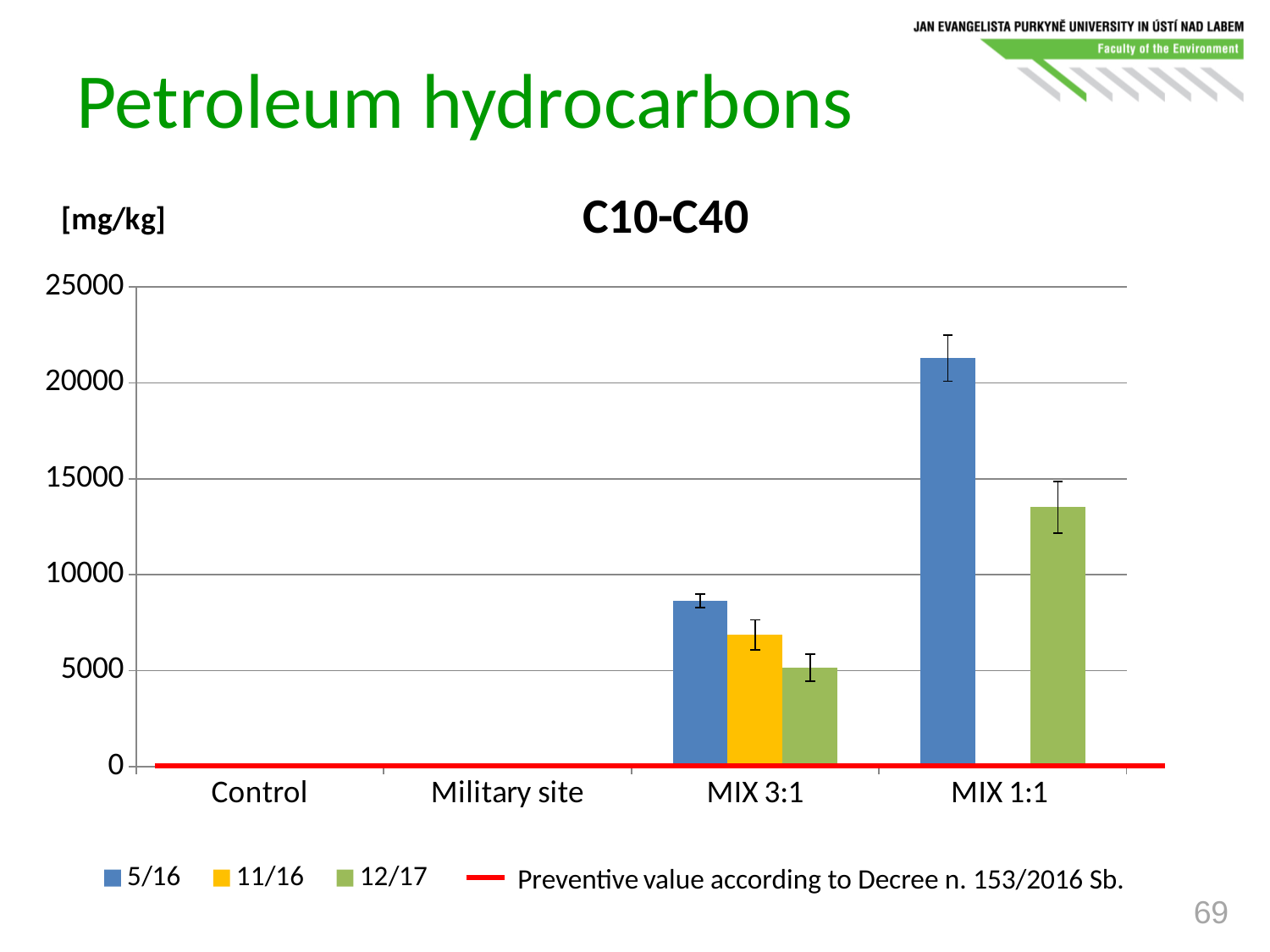
What kind of chart is shown on the slide? bar chart What unit is shown for the y axis of the chart? [mg/kg] How many categories are shown on the x axis of the chart? 4 How many entries does the chart legend list? 4 Is the 5/16 value for MIX 3:1 greater or less than 10000? less Which is larger for MIX 3:1, the 5/16 value or the 12/17 value? 5/16 Is the 5/16 value for MIX 1:1 greater or less than 20000? greater Is the 12/17 value for MIX 1:1 greater or less than 15000? less What is the title of the chart? C10-C40 Which series has the tallest bar within the MIX 1:1 category? 5/16 Which category has the tallest bar in the chart? MIX 1:1